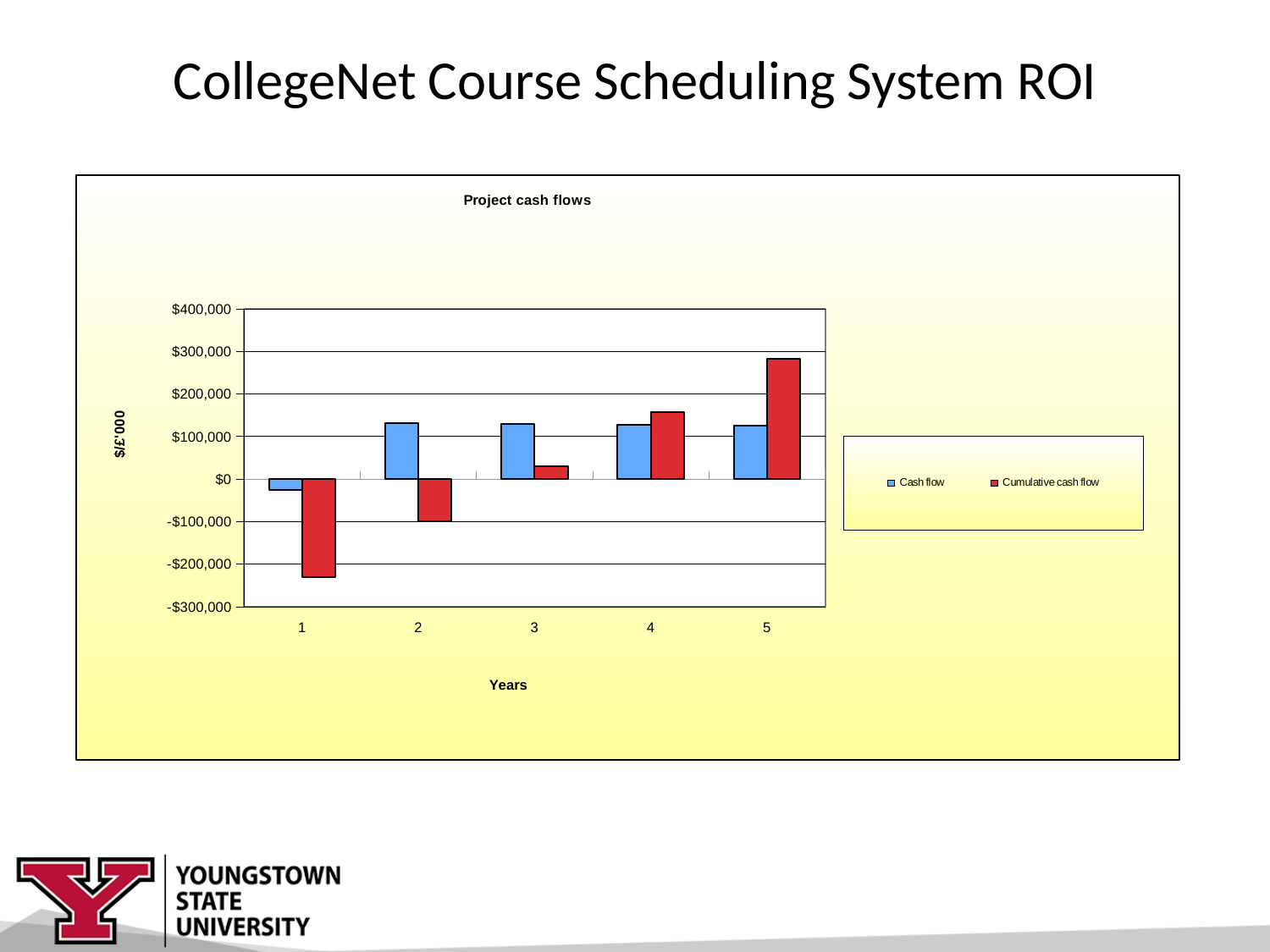
In which year is the cumulative cash flow highest? 5 Is the cumulative cash flow in year 1 greater or less than -$200,000? less What kind of chart is shown on the slide? bar chart Does the cumulative cash flow rise or fall from year 1 to year 5? rise In which year is the cumulative cash flow lowest? 1 What is the label on the x axis of the chart? Years In year 4, which is larger: the cash flow or the cumulative cash flow? Cumulative cash flow How many years are shown on the x axis? 5 What is the title of the chart? Project cash flows Is the cash flow in year 2 greater or less than $100,000? greater How many series does the legend list? 2 Is the cumulative cash flow in year 5 greater or less than $200,000? greater